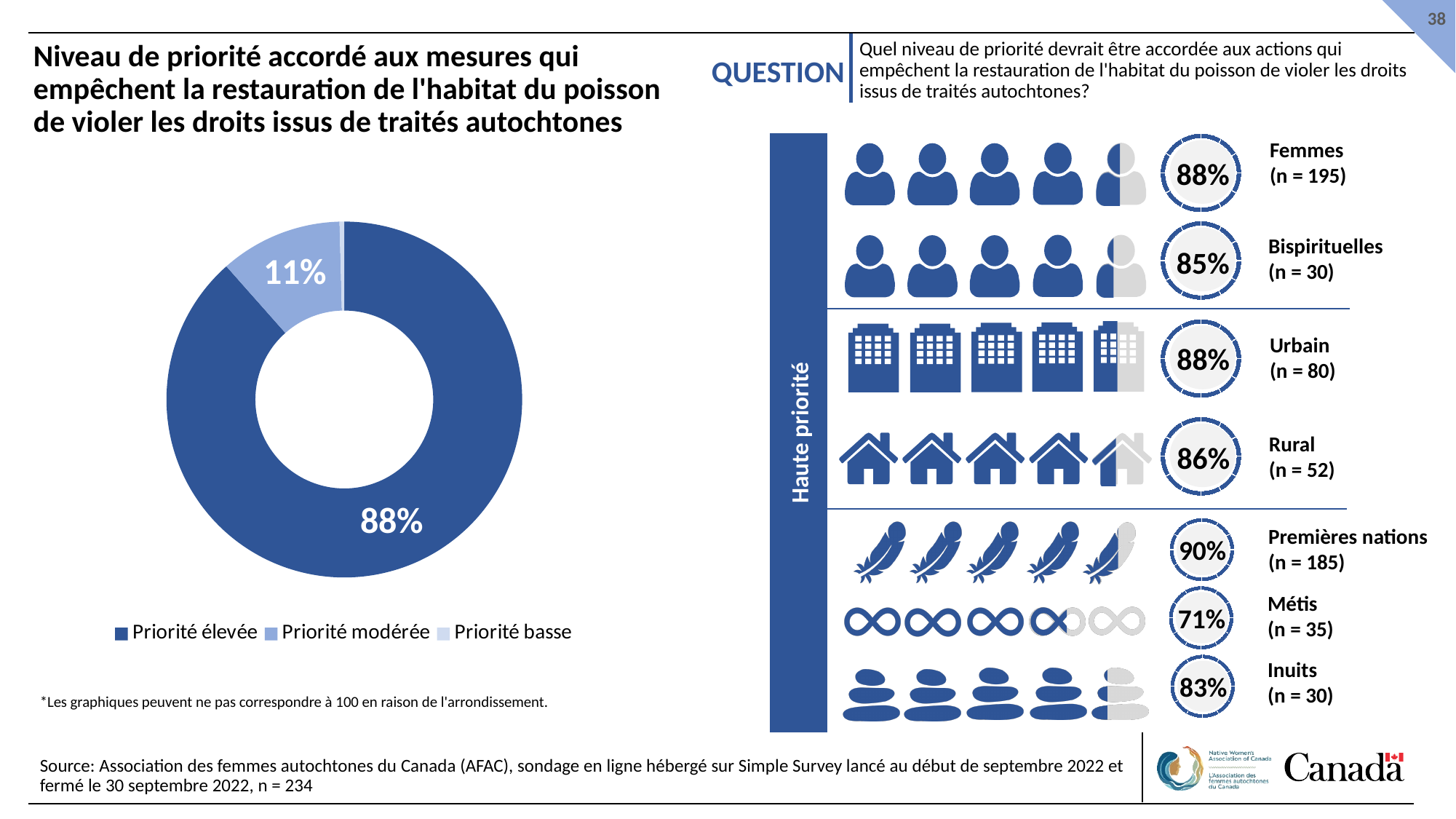
In the donut chart on the left, what is the difference in percentage points between Priorité élevée and Priorité modérée? 77 percentage points In the donut chart on the left, which category has the smallest slice? Priorité basse In the donut chart on the left, what share is shown for Priorité élevée? 88% In the donut chart on the left, what share is shown for Priorité modérée? 11% In the 'Haute priorité' infographic on the right, which group has the lowest percentage? Métis In the 'Haute priorité' infographic on the right, what is the difference in percentage points between Urbain and Rural? 2 percentage points In the 'Haute priorité' infographic on the right, which group has the highest percentage? Premières nations In the 'Haute priorité' infographic on the right, what percentage is shown for Premières nations? 90% In the 'Haute priorité' infographic on the right, what percentage is shown for Métis? 71% How many categories does the legend of the donut chart on the left list? 3 What kind of chart is the chart on the left of the slide? Donut (pie) chart In the donut chart on the left, which category has the largest slice? Priorité élevée